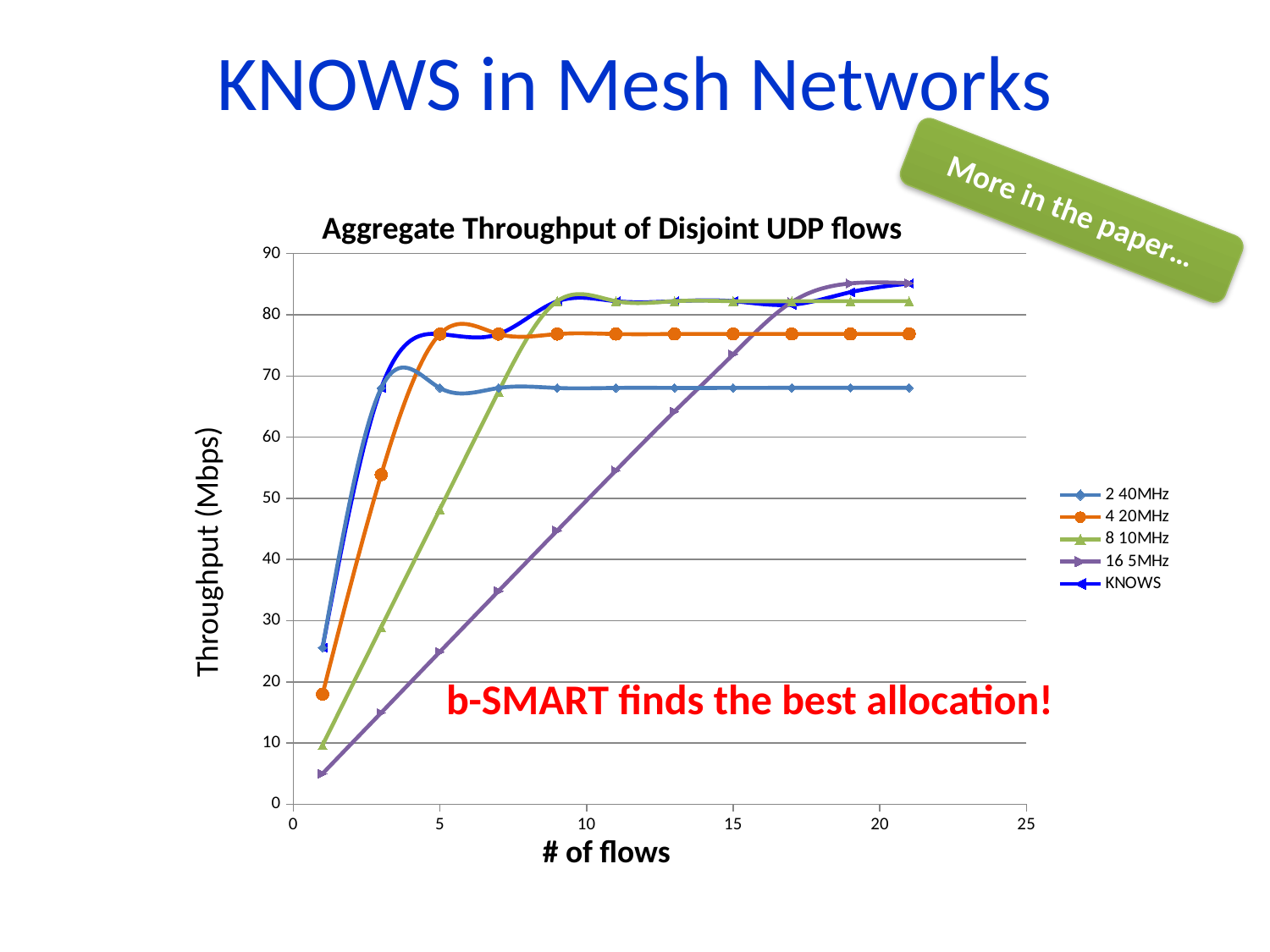
At 11 flows, which is larger: 8 10MHz or 16 5MHz? 8 10MHz How many series does the legend list? 5 What is the title of the chart? Aggregate Throughput of Disjoint UDP flows Is the value for 2 40MHz at 21 flows greater or less than 70? less Which series has the lowest throughput at 21 flows? 2 40MHz Is the value for 4 20MHz at 21 flows greater or less than 70? greater What is the label of the y axis? Throughput (Mbps) Is the value for 16 5MHz at 1 flow greater or less than 10? less Which series has the lowest throughput at 1 flow? 16 5MHz What kind of chart is shown on the slide? line chart Does the 16 5MHz series rise or fall as the number of flows increases? rises